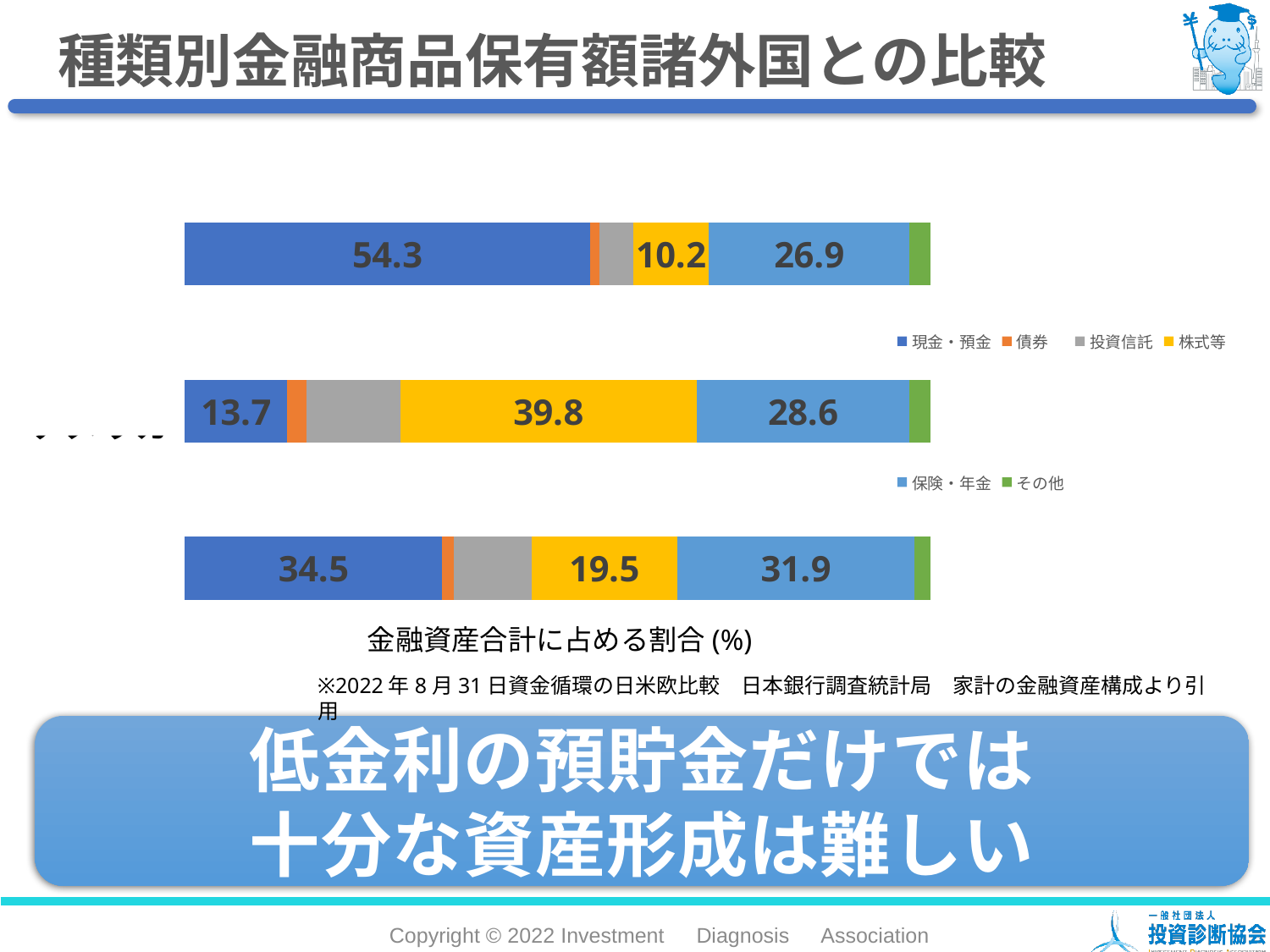
What is the value of 現金・預金 for the top bar? 54.3 What kind of chart is shown on the slide? stacked bar chart How many bars are plotted in the chart? 3 Which is larger: 株式等 in the bottom bar or 株式等 in the top bar? 株式等 in the bottom bar Which legend entry is shown in yellow? 株式等 Which bar has the highest value for 現金・預金: top, middle or bottom? top Which bar has the lowest value for 株式等: top, middle or bottom? top What is the value of 現金・預金 for the middle bar? 13.7 What is the value of 株式等 for the middle bar? 39.8 How many series does the chart's legend list? 6 What is the difference between the 現金・預金 values of the top bar and the middle bar? 40.6 What is the value of 保険・年金 for the bottom bar? 31.9